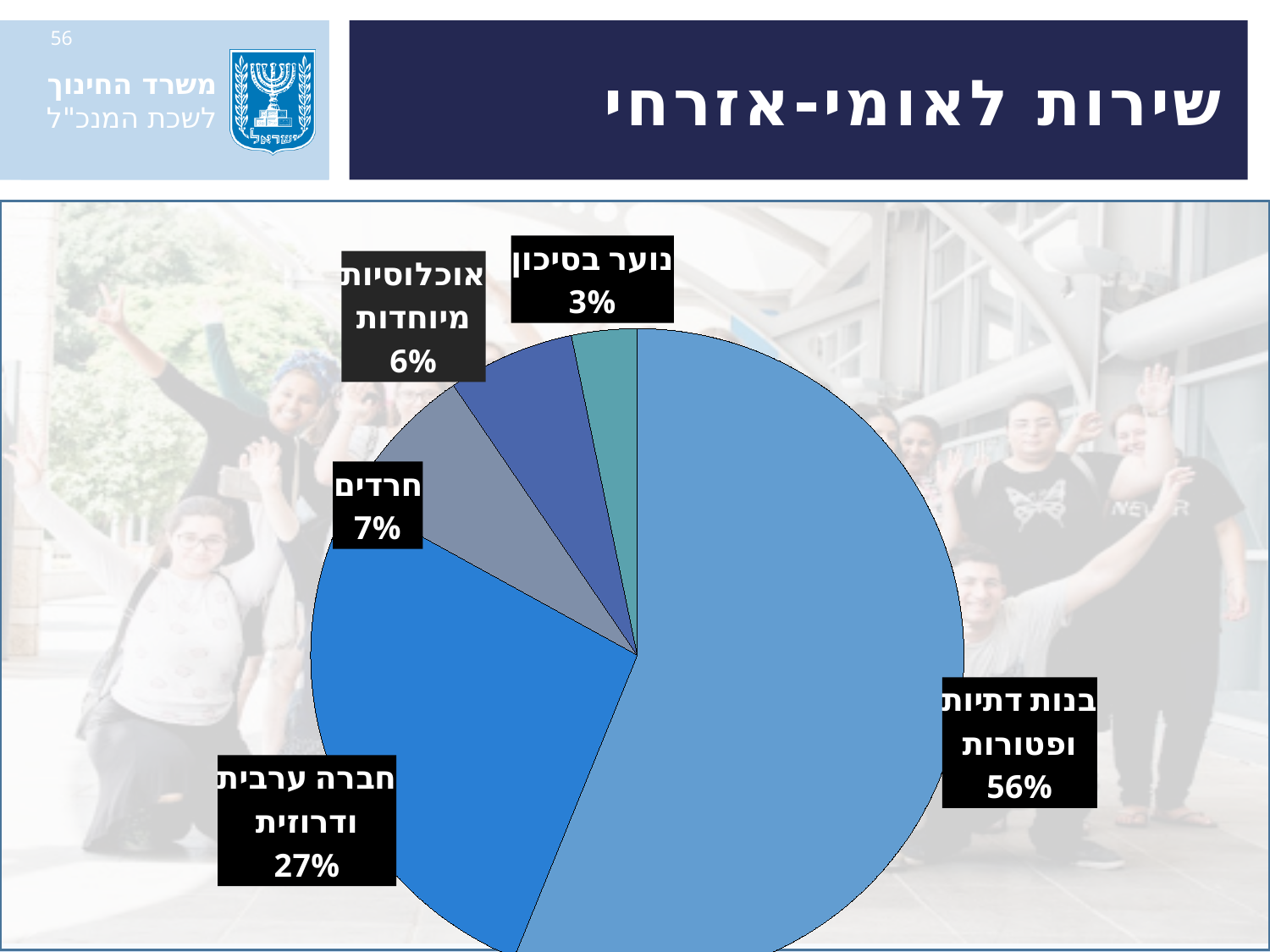
Which is larger, the slice for חרדים or the slice for אוכלוסיות מיוחדות? חרדים What share of the pie does חברה ערבית ודרוזית hold? 27% How many slices does the pie chart have? 5 What is the title of the slide containing the pie chart? שירות לאומי-אזרחי What share of the pie does בנות דתיות ופטורות hold? 56% What share of the pie does נוער בסיכון hold? 3% What share of the pie does אוכלוסיות מיוחדות hold? 6% Which category has the largest slice of the pie? בנות דתיות ופטורות Which category has the smallest slice of the pie? נוער בסיכון What is the difference in percentage points between בנות דתיות ופטורות and חברה ערבית ודרוזית? 29 What kind of chart is shown on the slide? pie chart What share of the pie does חרדים hold? 7%